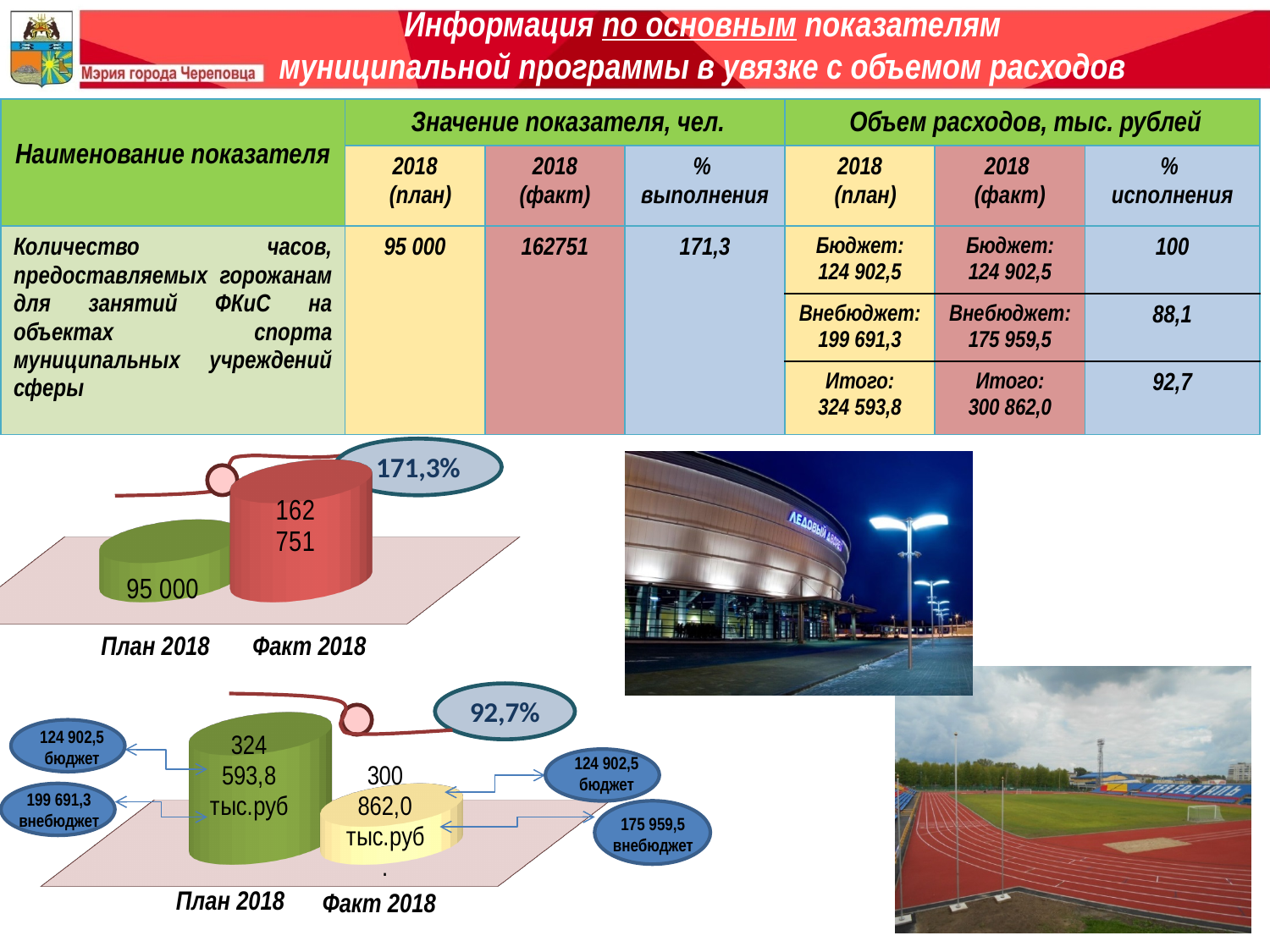
In the bottom-left chart, what is the value for План 2018? 324 593,8 тыс.руб In the bottom-left chart, which category has the lower value, План 2018 or Факт 2018? Факт 2018 In the bottom-left chart, what is the value for Факт 2018? 300 862,0 тыс.руб In the top-left chart, what is the value for План 2018? 95 000 In the bottom-left chart, what percentage is shown in the callout bubble? 92,7% In the top-left chart, which category has the higher value, План 2018 or Факт 2018? Факт 2018 In the top-left chart, what percentage is shown in the callout bubble? 171,3% In the bottom-left chart, what is the внебюджет amount annotated for План 2018? 199 691,3 In the top-left chart, what is the value for Факт 2018? 162 751 How many categories are plotted in the top-left chart? 2 In the bottom-left chart, what is the внебюджет amount annotated for Факт 2018? 175 959,5 What kind of chart is the top-left chart? bar chart